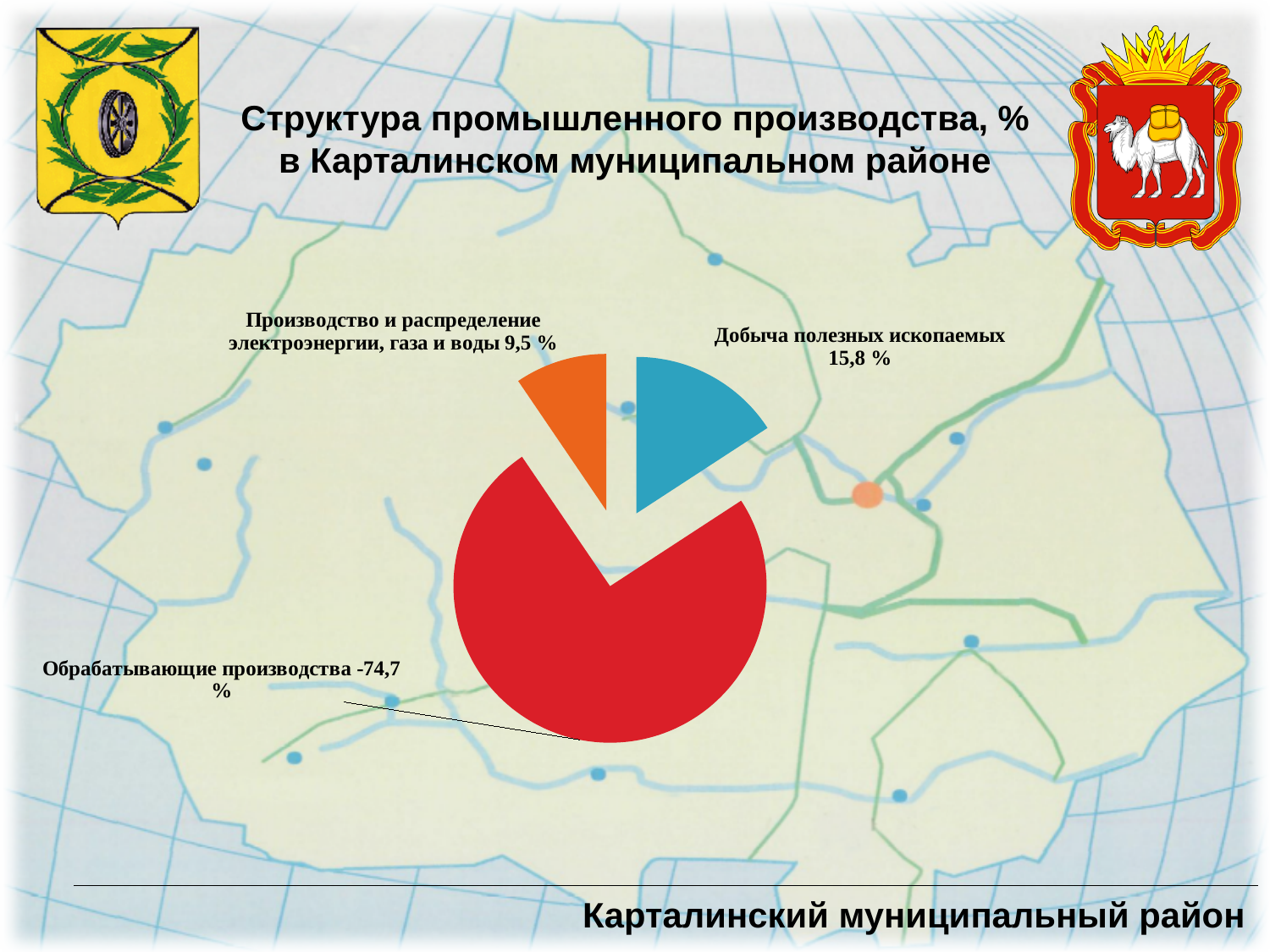
How many slices does the pie chart have? 3 What is the share of Добыча полезных ископаемых in the pie chart? 15,8 % Which category has the largest slice of the pie chart? Обрабатывающие производства By how many percentage points does the share of Обрабатывающие производства exceed the share of Добыча полезных ископаемых? 58,9 Which category has the smallest slice of the pie chart? Производство и распределение электроэнергии, газа и воды What is the title of the chart? Структура промышленного производства, % в Карталинском муниципальном районе What kind of chart is shown on the slide? pie chart Which is larger: the share of Добыча полезных ископаемых or the share of Производство и распределение электроэнергии, газа и воды? Добыча полезных ископаемых What colour is the slice for Добыча полезных ископаемых? blue By how many percentage points does the share of Добыча полезных ископаемых exceed the share of Производство и распределение электроэнергии, газа и воды? 6,3 What is the share of Обрабатывающие производства in the pie chart? 74,7 % What is the share of Производство и распределение электроэнергии, газа и воды in the pie chart? 9,5 %